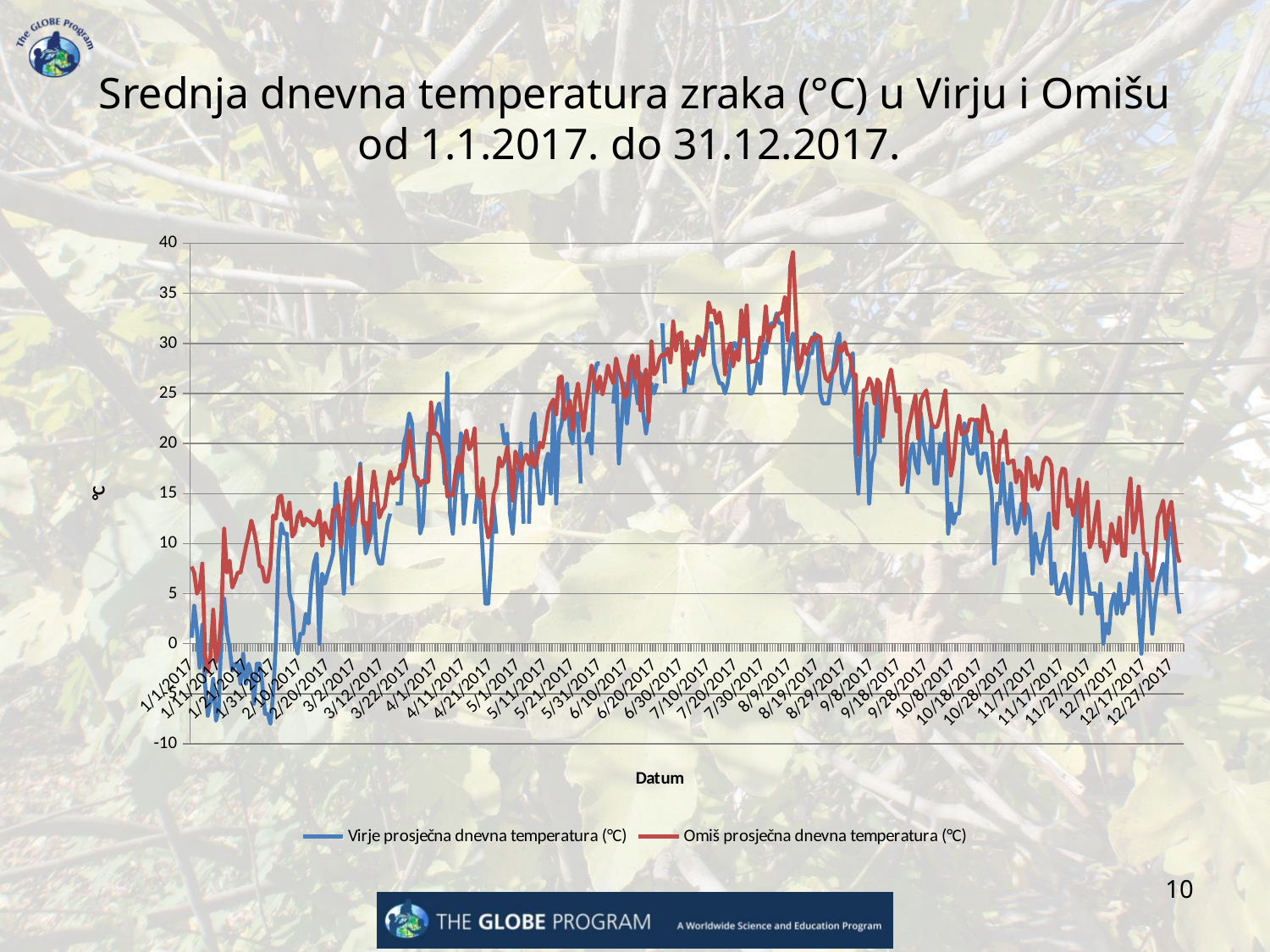
What kind of chart is shown on the slide? line chart What is the highest value shown on the vertical axis? 40 Which series reaches the lower minimum temperature, Virje or Omiš? Virje What is the lowest value shown on the vertical axis? -10 Is the highest value reached by the Omiš series greater or less than 35? greater Which series is generally higher during January 2017, Virje or Omiš? Omiš How many series does the legend list? 2 Is the lowest value reached by the Virje series in January greater or less than 0? less Do the temperatures rise or fall from January to July 2017? rise What is the label of the horizontal axis? Datum Which two locations are compared in the chart? Virje and Omiš Which series reaches the higher maximum temperature, Virje or Omiš? Omiš